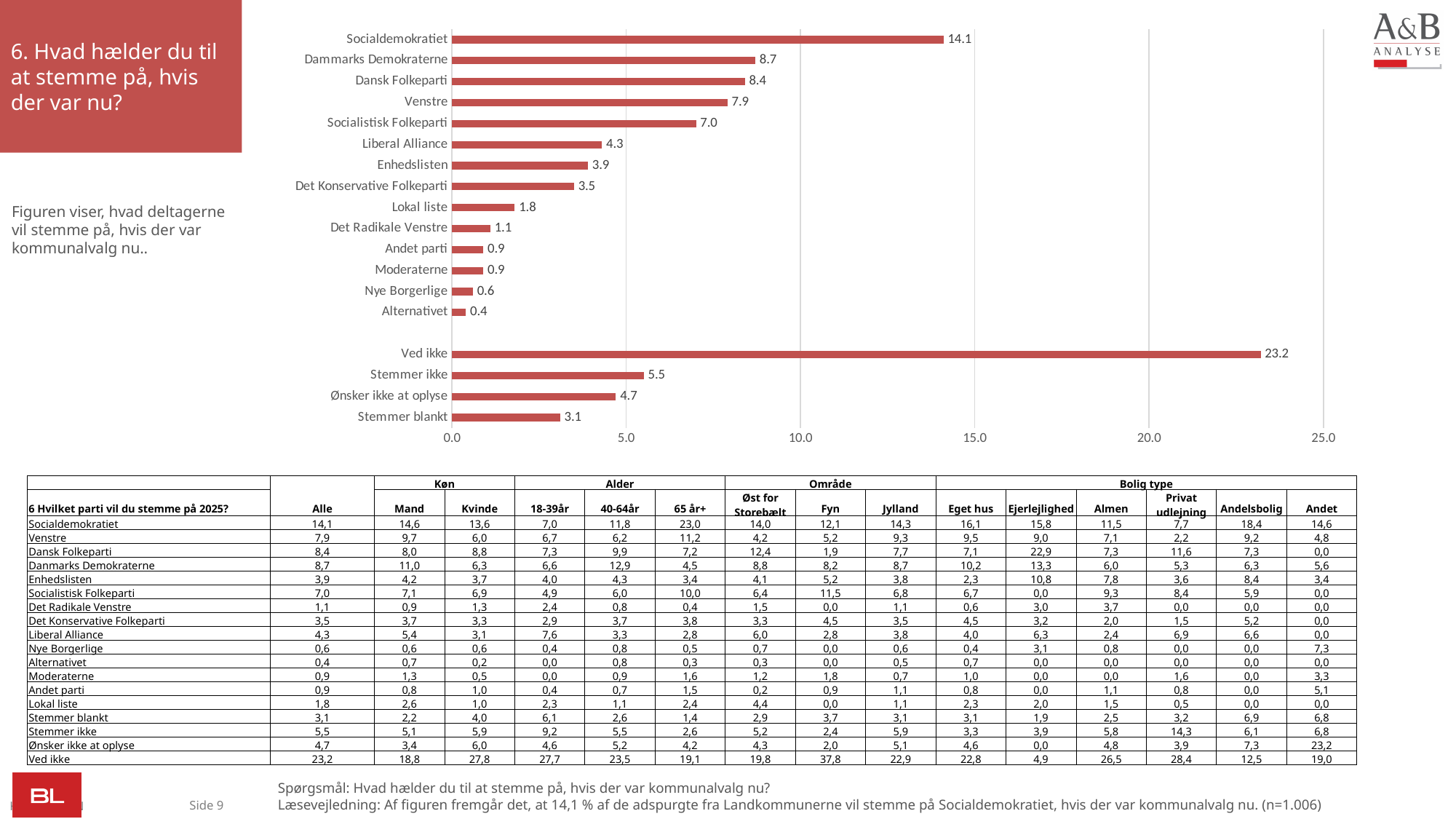
Which category has the lowest value in the bar chart? Alternativet Which has a larger value, Liberal Alliance or Enhedslisten? Liberal Alliance Which category has the highest value in the bar chart? Ved ikke What is the difference between the values for Socialdemokratiet and Dansk Folkeparti? 5.7 What is the value for Venstre in the bar chart? 7.9 How many bars are shown in the bar chart? 18 What is the value for Socialdemokratiet in the bar chart? 14.1 Is the value for Socialistisk Folkeparti greater or less than 5.0? greater What is the value for Ved ikke in the bar chart? 23.2 What is the maximum value shown on the x axis of the bar chart? 25.0 What kind of chart is shown on the slide? Bar chart What is the value for Alternativet in the bar chart? 0.4